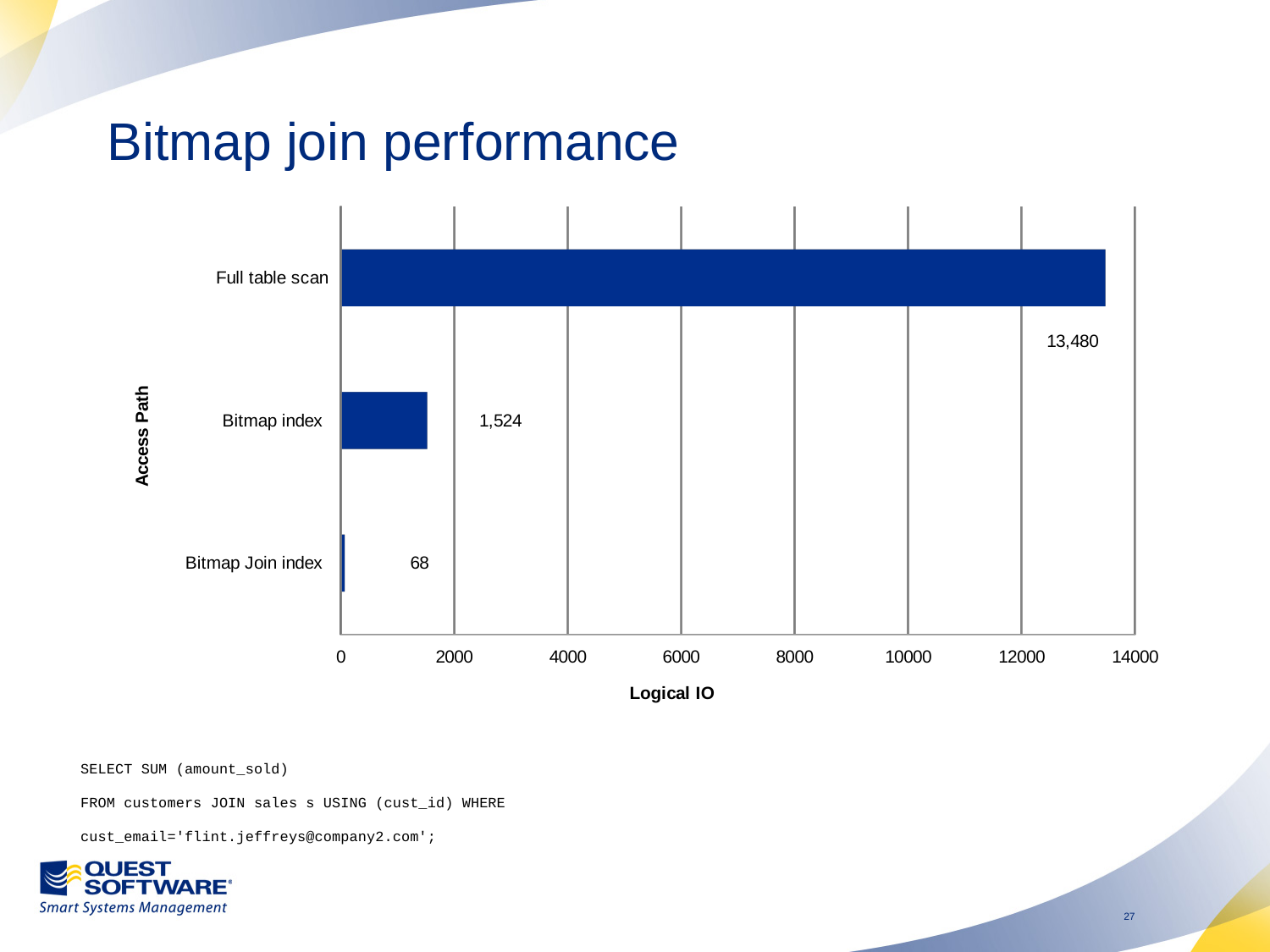
Which access path has the highest Logical IO? Full table scan What is the difference in Logical IO between Full table scan and Bitmap index? 11,956 Which has a larger Logical IO, Bitmap index or Bitmap Join index? Bitmap index What is the Logical IO value for Bitmap Join index? 68 What is the label of the horizontal axis of the chart? Logical IO Is the Logical IO for Full table scan greater or less than 12000? greater What is the Logical IO value for Full table scan? 13,480 Which access path has the lowest Logical IO? Bitmap Join index What is the difference in Logical IO between Bitmap index and Bitmap Join index? 1,456 What kind of chart is shown on the slide? Bar chart How many access paths are shown in the chart? 3 What is the Logical IO value for Bitmap index? 1,524